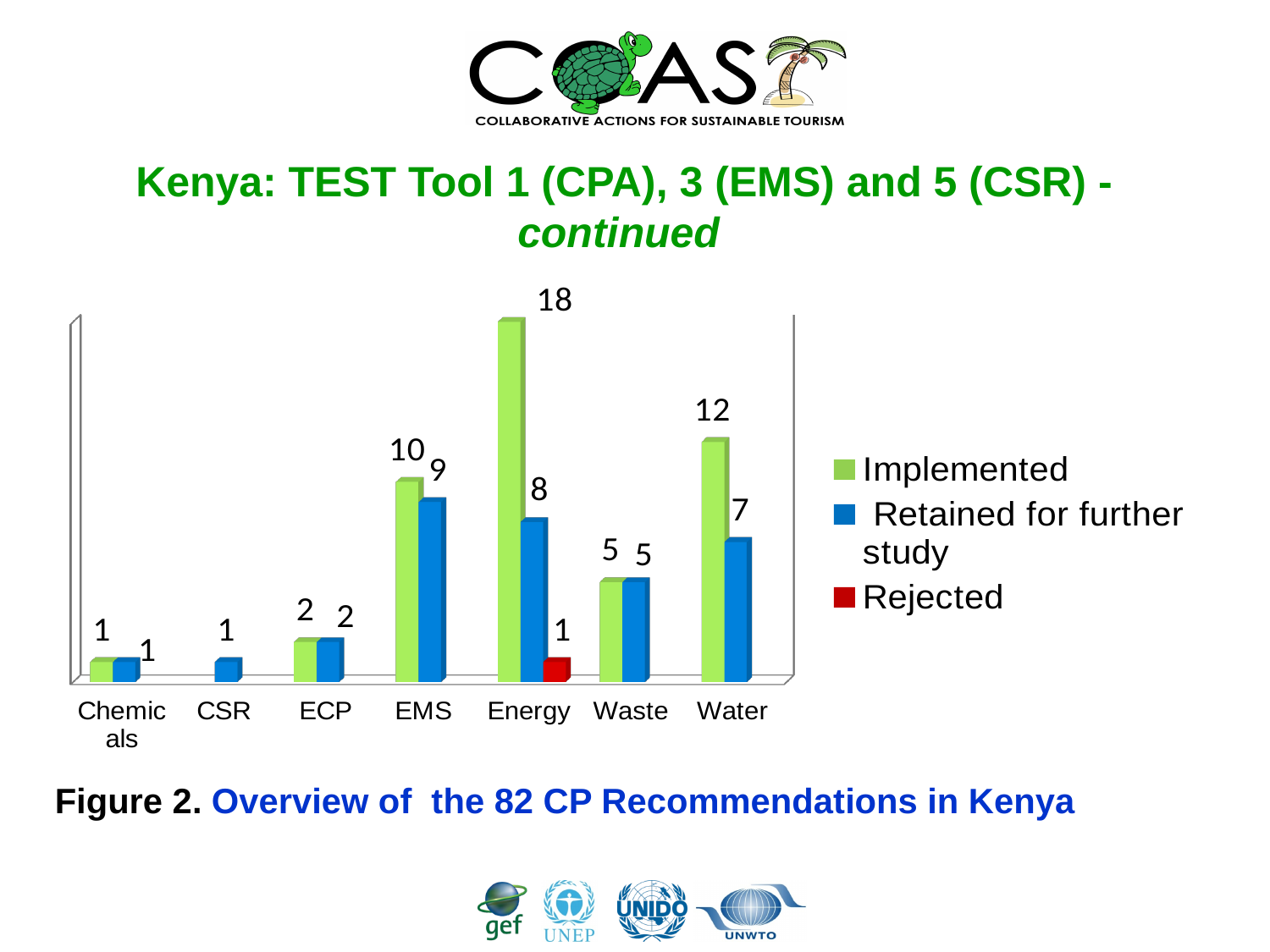
How many categories are shown on the x axis? 7 Which is larger for EMS: the Implemented value or the Retained for further study value? Implemented How many series does the legend list? 3 What is the Retained for further study value for Water? 7 What is the Implemented value for Energy? 18 Which series is shown in red in the legend? Rejected What is the Rejected value for Energy? 1 What is the difference between the Implemented and Retained for further study values for Water? 5 What is the Retained for further study value for EMS? 9 What kind of chart is shown on the slide? Bar chart Which category has the highest Implemented value? Energy Which category has the lowest Retained for further study value? Chemicals and CSR (both 1)